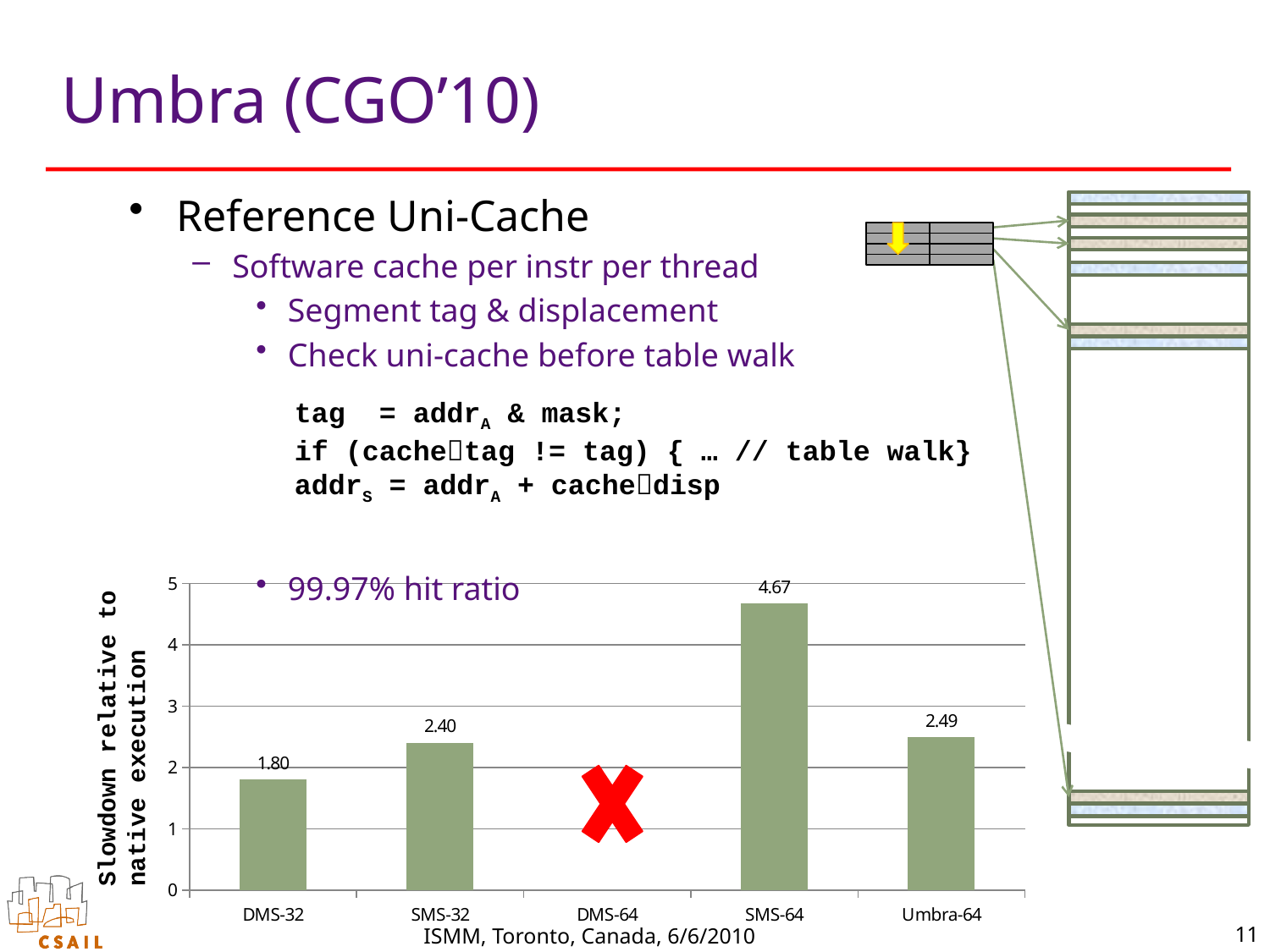
What kind of chart is shown on the slide? Bar chart Which category with a plotted bar has the lowest slowdown? DMS-32 What is the difference between the slowdown of SMS-64 and Umbra-64? 2.18 What is the slowdown value shown for DMS-32? 1.80 Which has a larger slowdown, SMS-64 or DMS-32? SMS-64 Which category has the highest slowdown in the chart? SMS-64 What is the difference between the slowdown of SMS-32 and DMS-32? 0.60 What is the slowdown value shown for Umbra-64? 2.49 What is the slowdown value shown for SMS-64? 4.67 How many categories are labeled on the x axis of the chart? 5 Is the value for DMS-32 greater or less than 2? less What is the slowdown value shown for SMS-32? 2.40